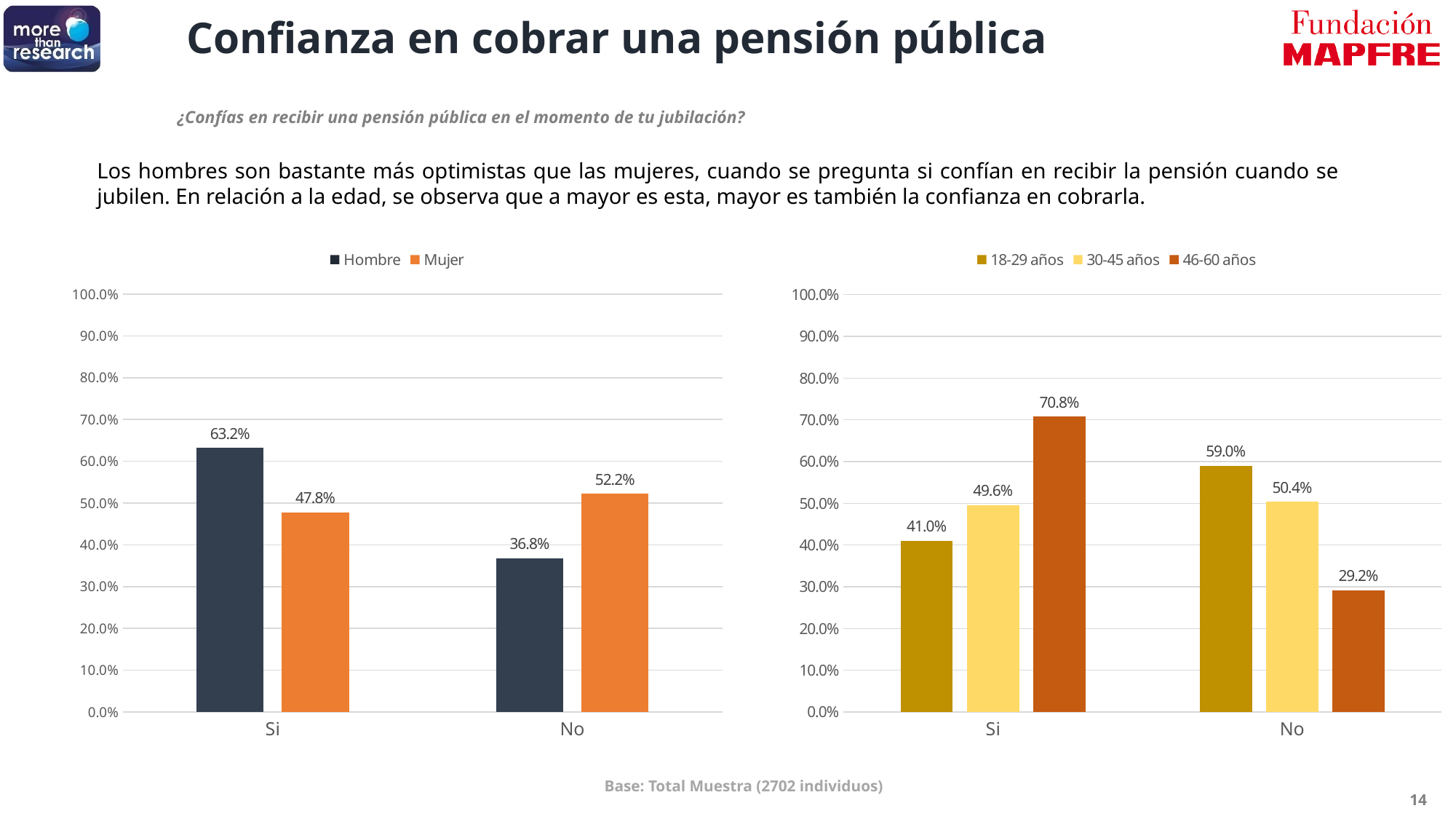
In the left chart (Hombre/Mujer), what is the value for Mujer in the No category? 52.2% In the right chart (age groups), which age group has the highest value in the Si category? 46-60 años In the left chart (Hombre/Mujer), how many series does the legend list? 2 In the left chart (Hombre/Mujer), what is the difference between Hombre and Mujer in the Si category? 15.4% In the left chart (Hombre/Mujer), what is the value for Hombre in the Si category? 63.2% What kind of chart is the left chart (Hombre/Mujer)? Bar chart In the right chart (age groups), which age group has the lowest value in the No category? 46-60 años In the left chart (Hombre/Mujer), which series has the larger value in the No category? Mujer In the right chart (age groups), how many series does the legend list? 3 In the right chart (age groups), what is the difference between 30-45 años and 18-29 años in the Si category? 8.6% In the right chart (age groups), what is the value for 46-60 años in the Si category? 70.8% In the right chart (age groups), what is the value for 18-29 años in the No category? 59.0%